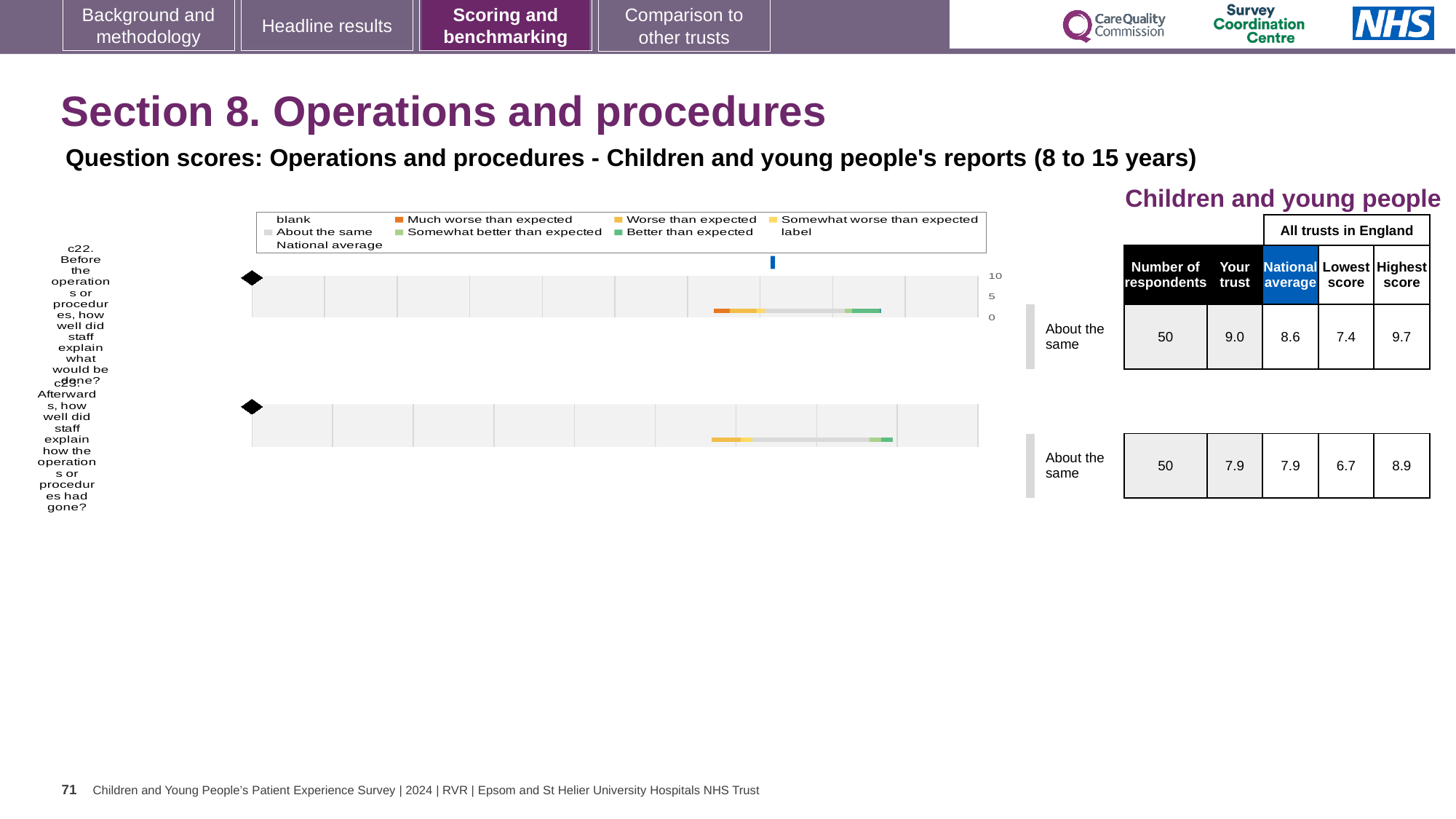
Which question has the higher 'Your trust' score, c22 or c23? c22 What benchmark category is the trust placed in for question c23? About the same Which legend entry is shown in blue in the chart? National average What is the difference between the trust's score and the national average for question c22? 0.4 What is the lowest score among all trusts in England for question c23? 6.7 What is the highest score among all trusts in England for question c22? 9.7 What is the national average score for question c23 (Afterwards, how well did staff explain how the operations or procedures had gone?)? 7.9 How many respondents answered question c22? 50 How many questions (categories) are plotted in the chart? 2 What kind of chart is used to show the question scores for c22 and c23? bar chart What is the 'Your trust' score for question c22 (Before the operations or procedures, how well did staff explain what would be done?)? 9.0 What is the difference between the highest and lowest trust scores in England for question c23? 2.2